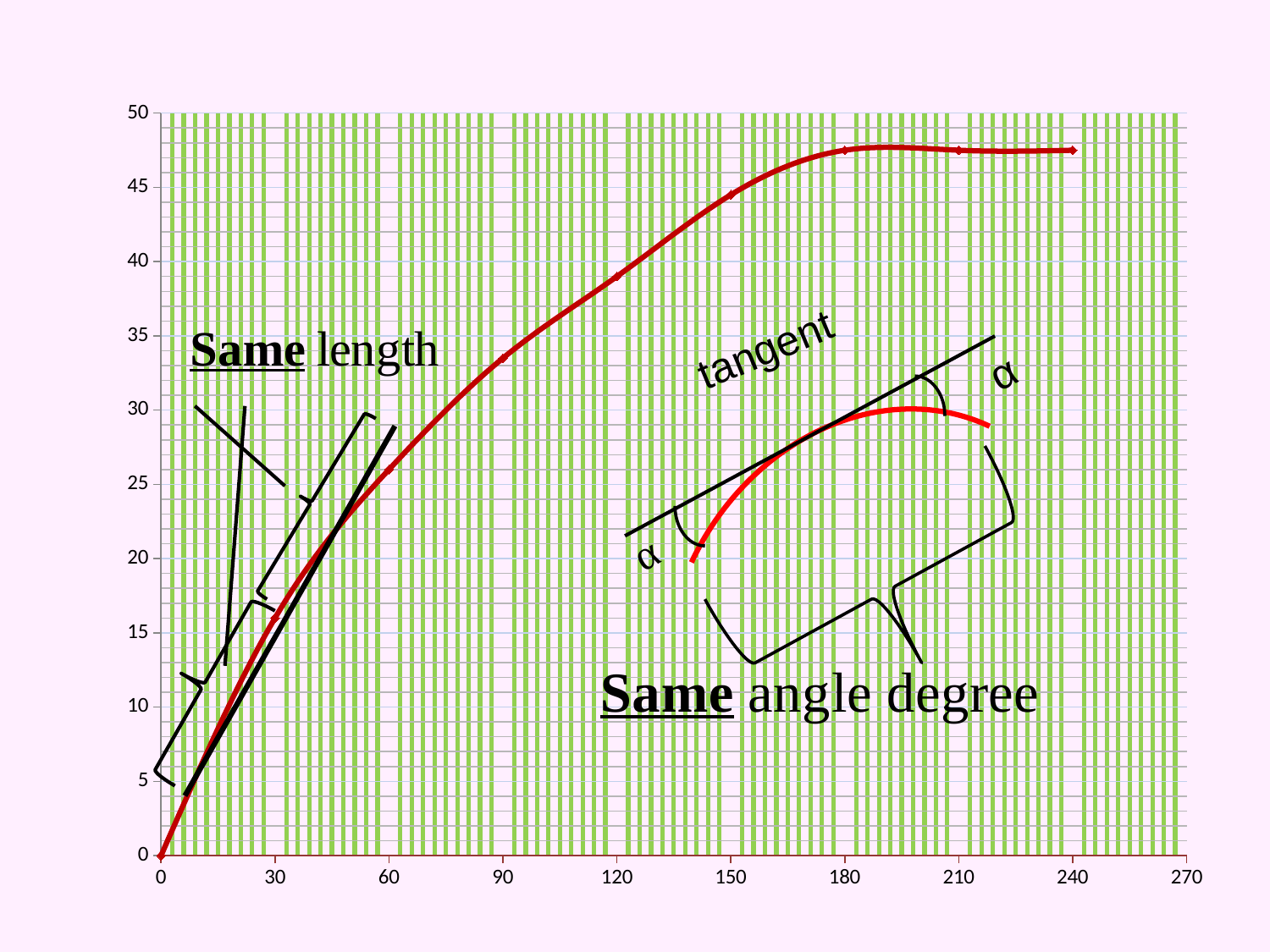
What kind of chart is shown on the slide? line chart Is the value of the red curve at x = 60 greater or less than 20? greater Which is larger, the value of the red curve at x = 30 or at x = 150? x = 150 Is the value of the red curve at x = 180 greater or less than 45? greater Is the value of the red curve at x = 90 greater or less than 35? less What is the value of the red curve at x = 0? 0 What word is written along the straight line touching the small red arc in the annotation on the right? tangent What is the highest value shown on the x axis? 270 Does the red curve rise or fall as the x axis goes from 0 to 180? rise At which x value is the red curve lowest? 0